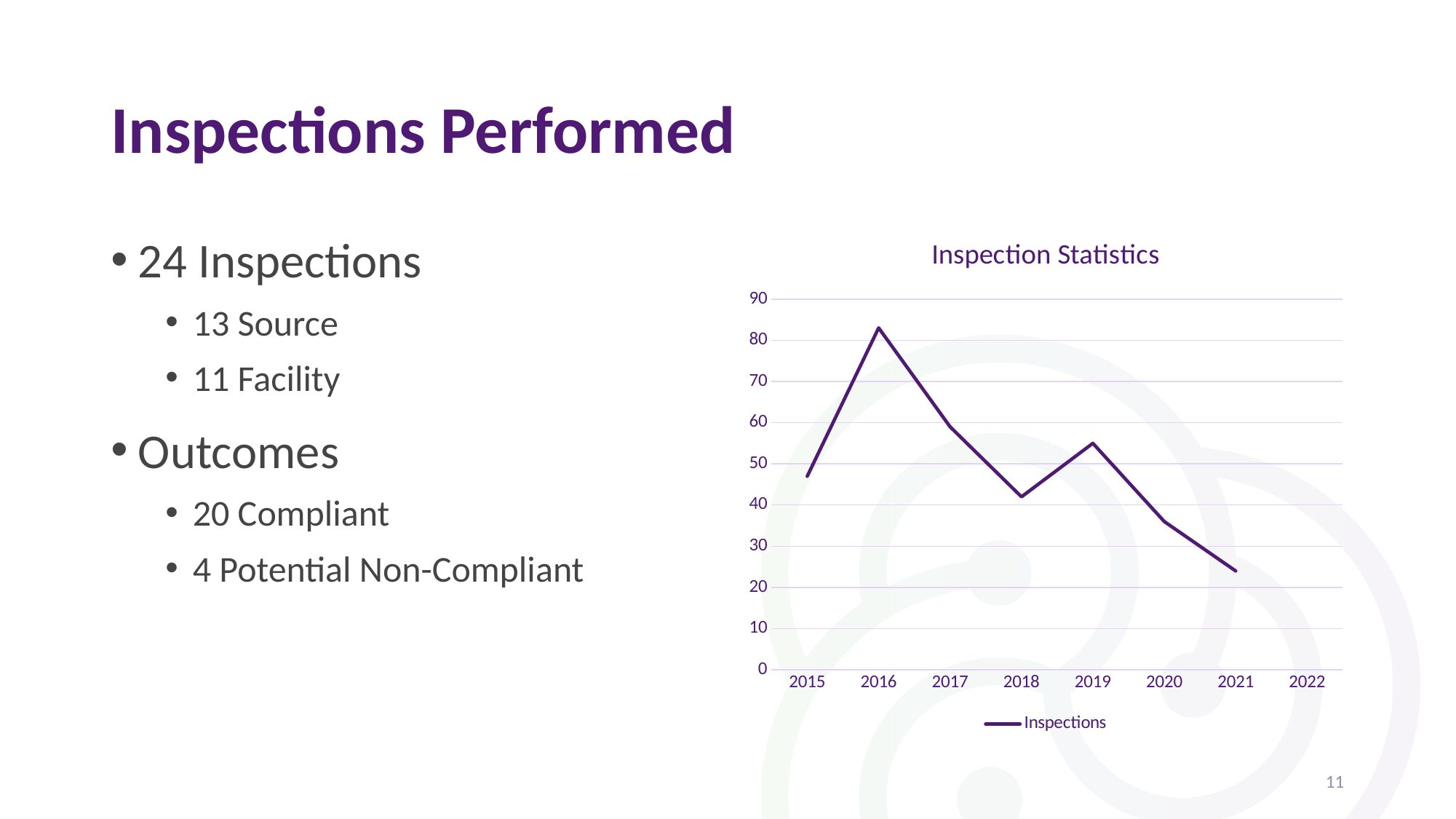
What kind of chart is shown on the slide? line chart Is the value for 2021 greater or less than 30? less Is the value for 2018 greater or less than 50? less What is the name of the series shown in the chart legend? Inspections How many years are labelled on the x axis of the chart? 8 Which year has the highest number of inspections? 2016 Which year has more inspections, 2016 or 2019? 2016 What is the title of the chart? Inspection Statistics How many series does the chart legend list? 1 Is the value for 2016 greater or less than 70? greater Which year with a plotted value has the lowest number of inspections? 2021 Do the inspection values rise or fall from 2019 to 2021? fall